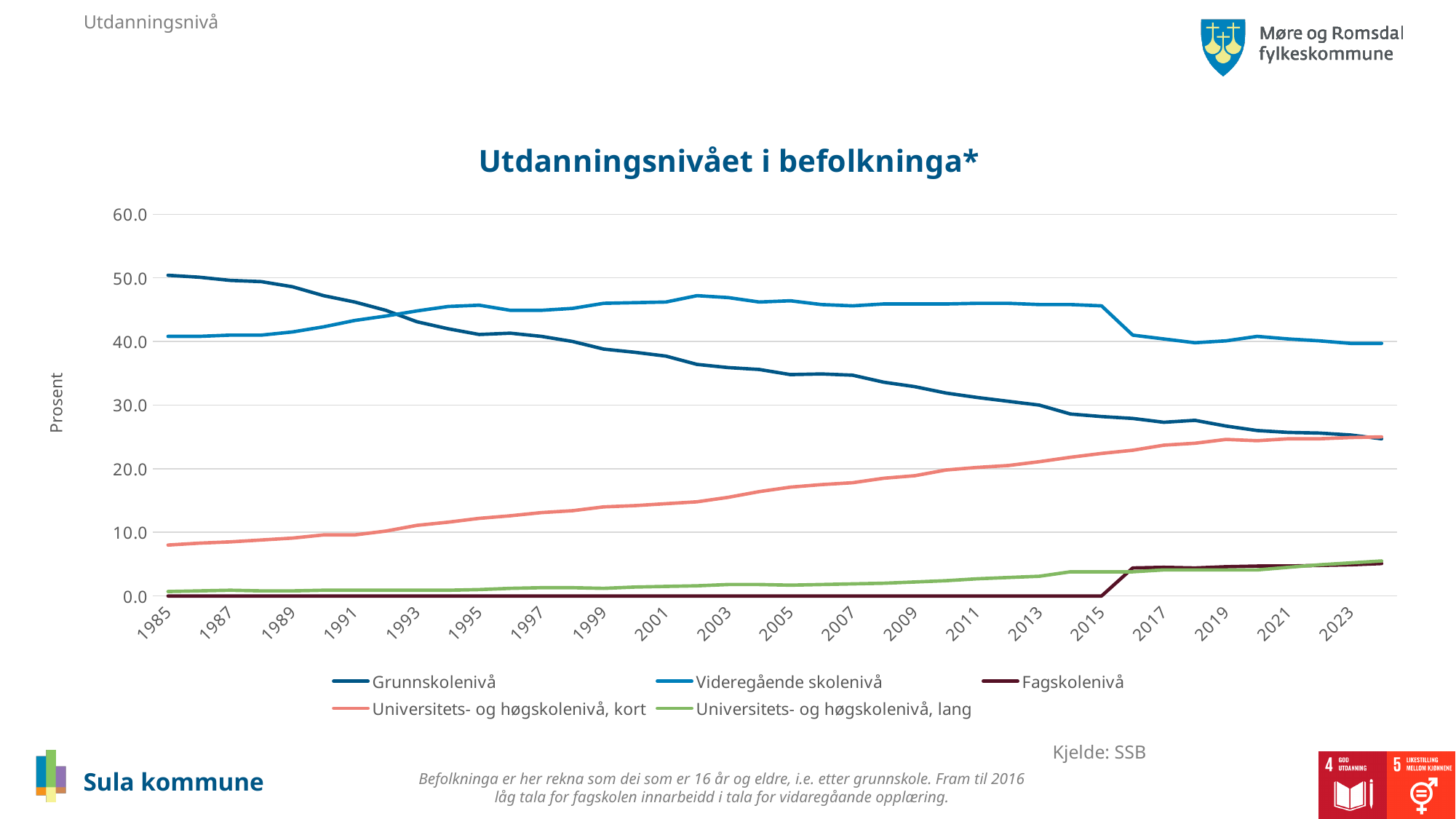
In 2023, which is larger: Grunnskolenivå or Videregående skolenivå? Videregående skolenivå Does the Grunnskolenivå line rise or fall from 1985 to 2023? fall Does the Universitets- og høgskolenivå, kort line rise or fall from 1985 to 2023? rise Which series has the highest value in 2023? Videregående skolenivå Which series has the lowest value in 1985? Fagskolenivå Is the value for Grunnskolenivå in 1985 greater or less than 40.0? greater Is the value for Universitets- og høgskolenivå, kort in 1985 greater or less than 10.0? less What is the title of the chart? Utdanningsnivået i befolkninga* Is the value for Fagskolenivå in 2023 greater or less than 10.0? less What kind of chart is shown on the slide? line chart How many series does the legend list? 5 In 1985, which is larger: Grunnskolenivå or Videregående skolenivå? Grunnskolenivå